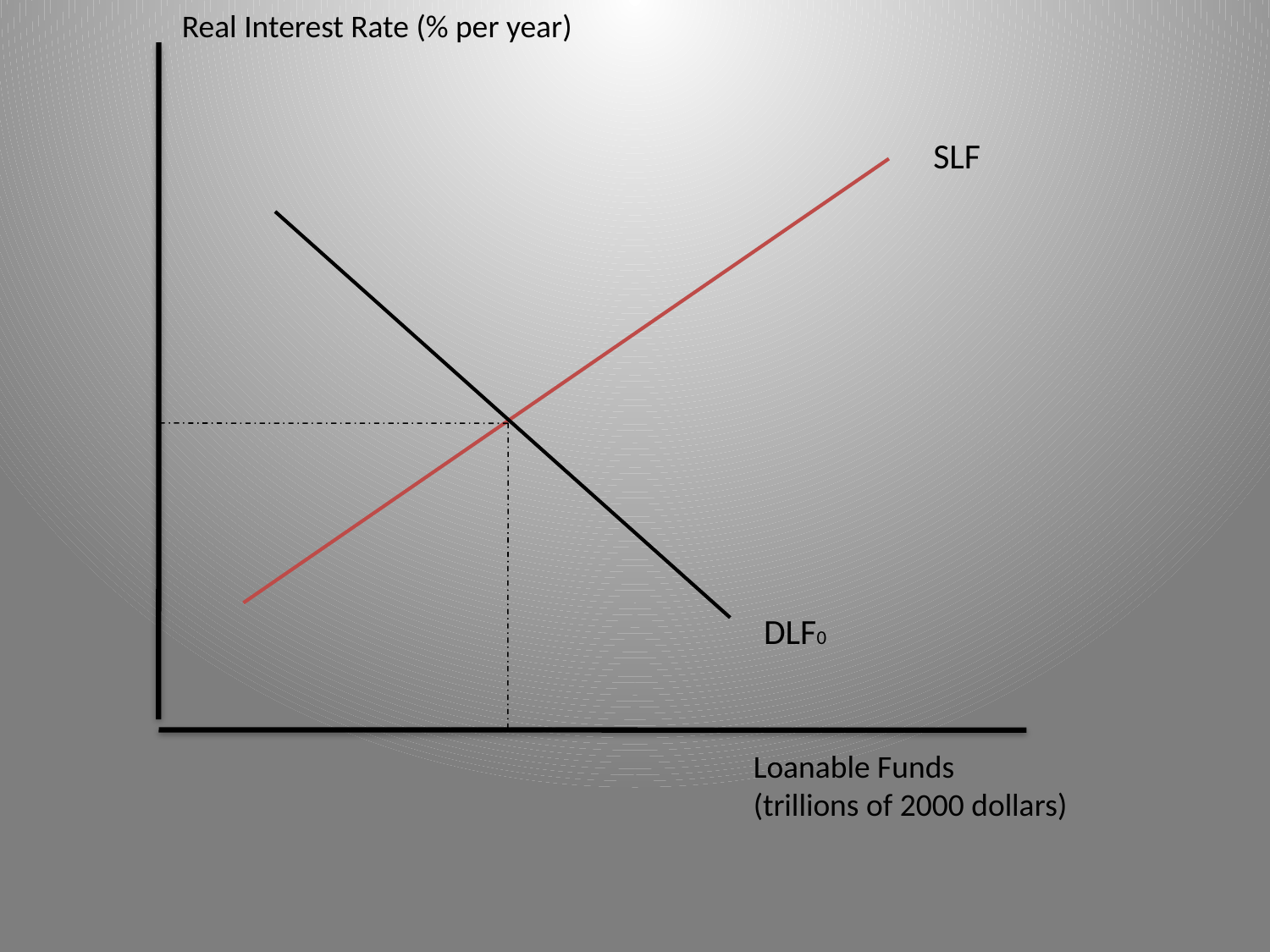
Does the SLF line rise or fall as you move right along the x axis? rise What colour is the SLF line? red Does the DLF0 line rise or fall as you move right along the x axis? fall How many curves are plotted on the chart? 2 What is the label of the vertical axis? Real Interest Rate (% per year) What kind of chart is shown on the slide? line chart